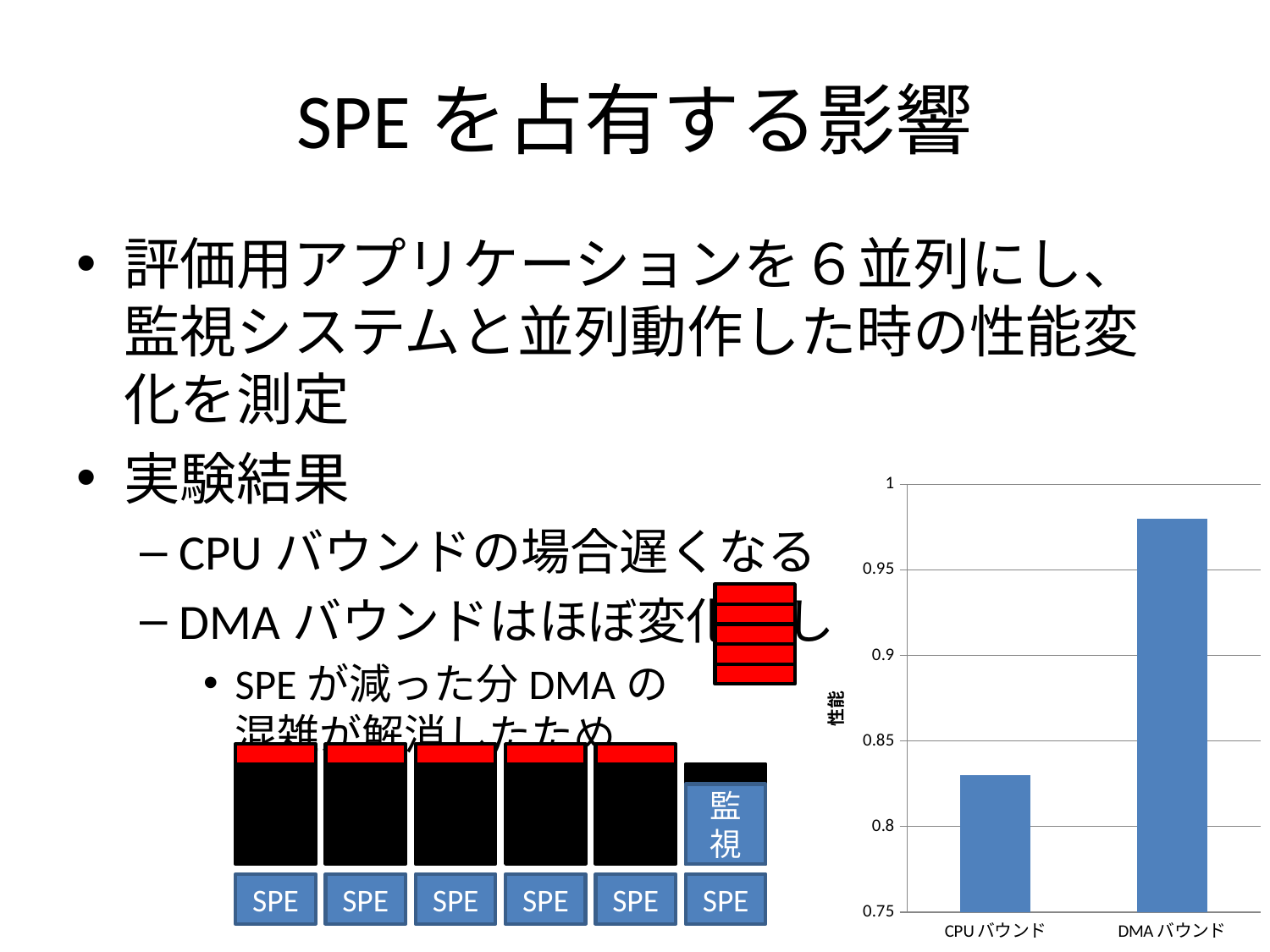
Which category has the highest value in the chart? DMA バウンド Do the bar values rise or fall from left to right along the x axis? rise Is the value for DMA バウンド greater or less than 1? less How many categories are plotted on the x axis of the chart? 2 What is the lowest tick value shown on the vertical axis of the chart? 0.75 Is the value for CPU バウンド greater or less than 0.85? less Which category has the lowest value in the chart? CPU バウンド What is the label on the vertical axis of the chart? 性能 What kind of chart is shown on the slide? bar chart Is the value for CPU バウンド greater or less than 0.8? greater Which is larger, the value for CPU バウンド or the value for DMA バウンド? DMA バウンド